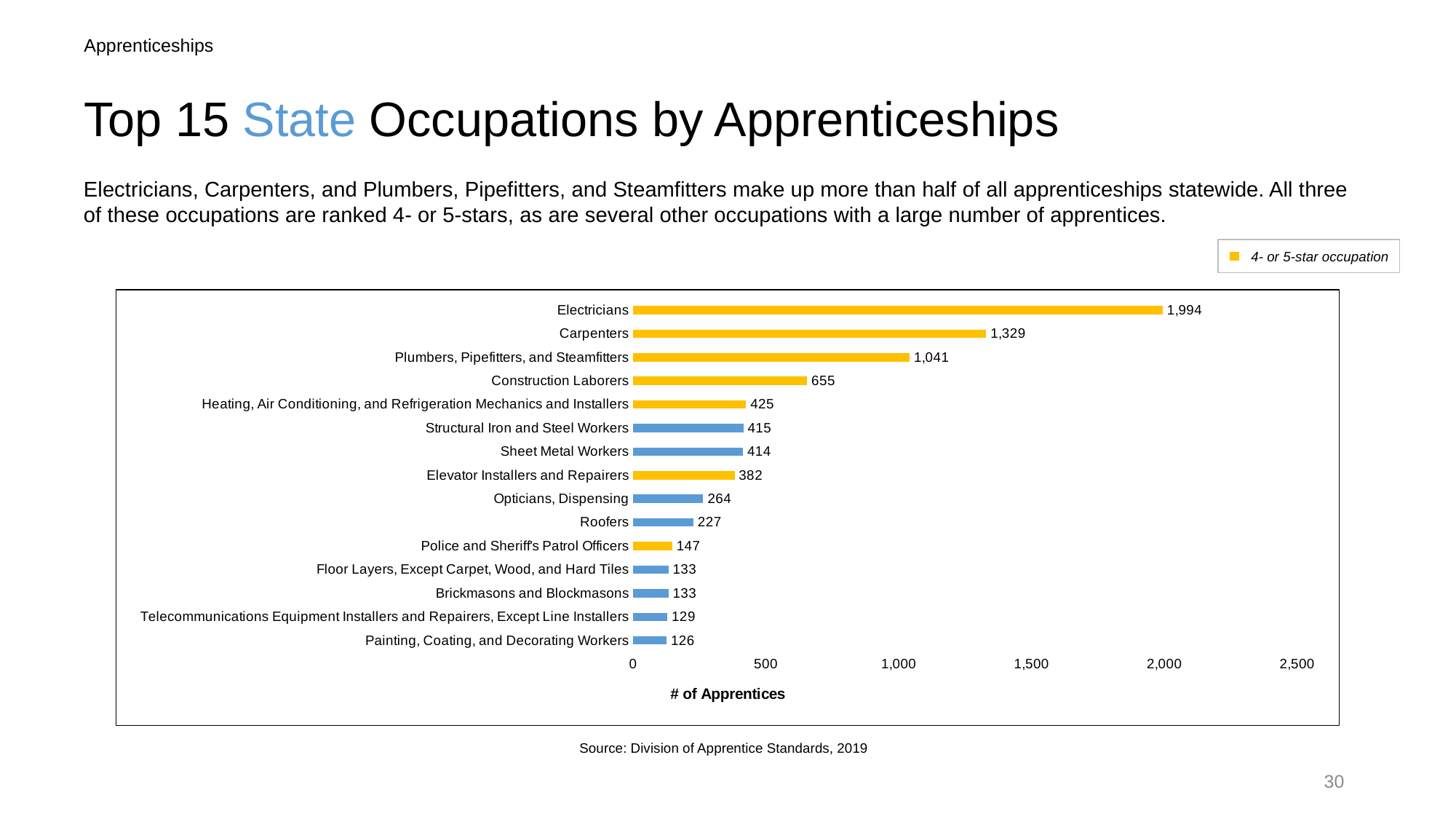
Which occupation has the lowest number of apprentices on the chart? Painting, Coating, and Decorating Workers How many occupations are shown on the chart? 15 What is the difference in apprentices between Electricians and Carpenters? 665 What does the yellow bar colour indicate according to the legend? 4- or 5-star occupation What kind of chart is shown on the slide? Bar chart What is the difference in apprentices between Construction Laborers and Elevator Installers and Repairers? 273 Which has more apprentices, Opticians, Dispensing or Roofers? Opticians, Dispensing How many apprentices are shown for Roofers? 227 What is the label of the horizontal axis? # of Apprentices Which occupation has the highest number of apprentices? Electricians How many apprentices are shown for Electricians? 1,994 How many apprentices are shown for Sheet Metal Workers? 414